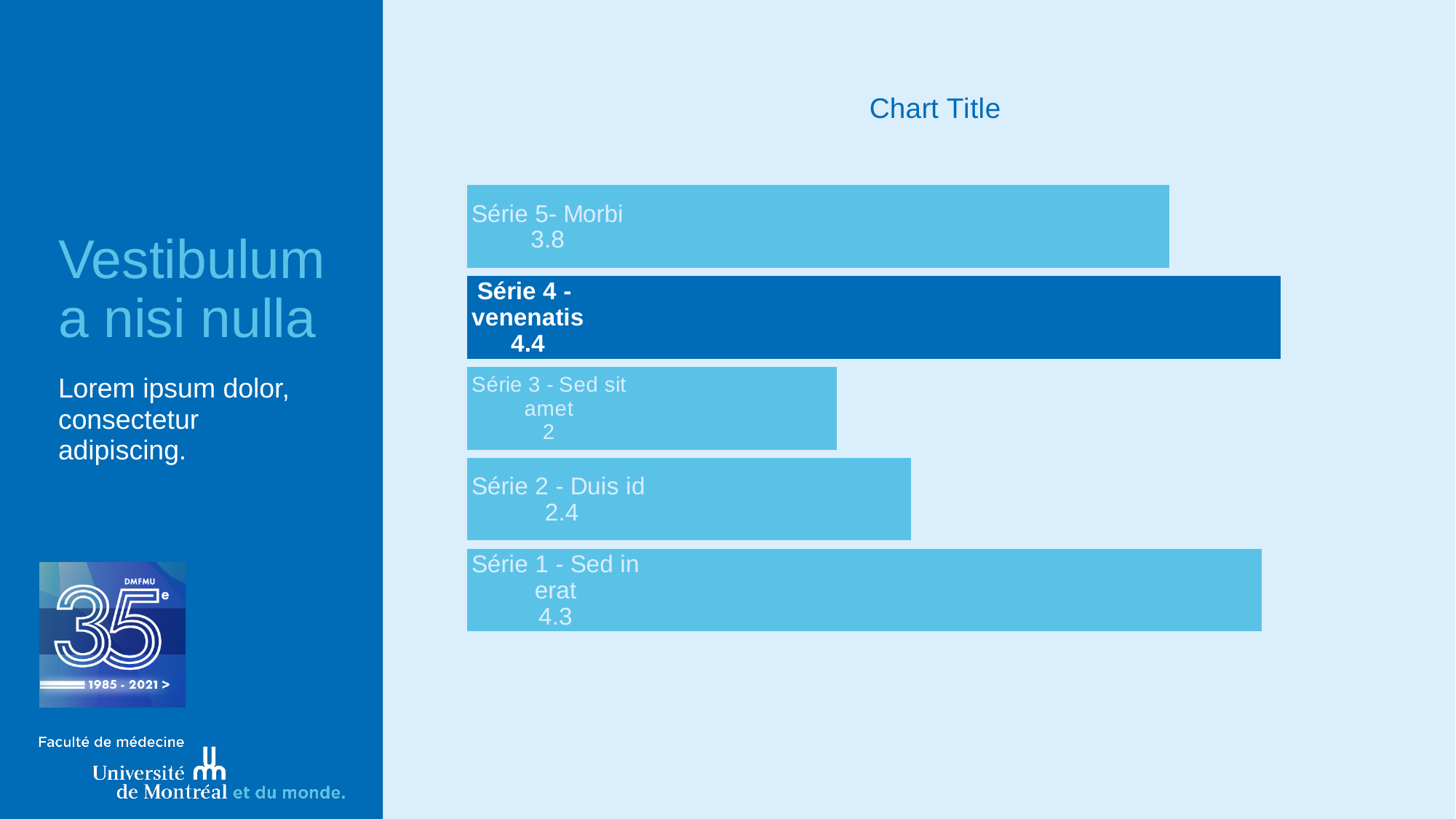
What is the value for Série 2 - Duis id? 2.4 What is the difference between the values for Série 4 - venenatis and Série 3 - Sed sit amet? 2.4 What is the value for Série 3 - Sed sit amet? 2 How many bars are shown in the chart? 5 What kind of chart is shown on the slide? Bar chart Which category has the highest value? Série 4 - venenatis Which is larger, the value for Série 5- Morbi or the value for Série 2 - Duis id? Série 5- Morbi Which category has the lowest value? Série 3 - Sed sit amet What is the value for Série 4 - venenatis? 4.4 What is the value for Série 5- Morbi? 3.8 What is the value for Série 1 - Sed in erat? 4.3 What is the difference between the values for Série 5- Morbi and Série 2 - Duis id? 1.4